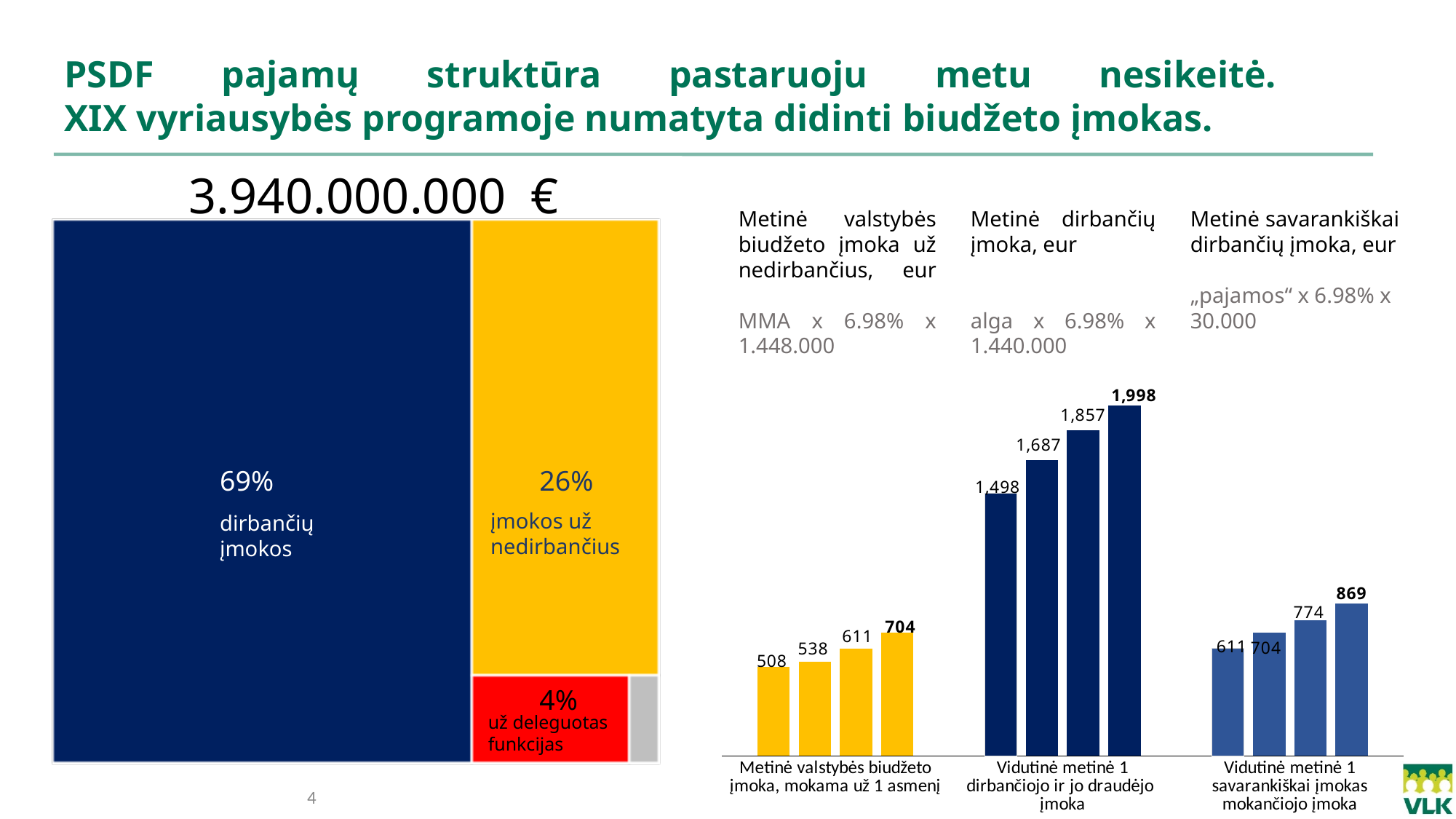
In the right chart, which category group has the tallest bars: 'Metinė valstybės biudžeto įmoka, mokama už 1 asmenį' or 'Vidutinė metinė 1 dirbančiojo ir jo draudėjo įmoka'? Vidutinė metinė 1 dirbančiojo ir jo draudėjo įmoka In the left chart, what share is labelled 'už deleguotas funkcijas'? 4% In the right chart, what is the difference between the highest and lowest values for 'Metinė valstybės biudžeto įmoka, mokama už 1 asmenį'? 196 In the left chart, what share of PSDF income comes from 'dirbančių įmokos'? 69% In the right chart, what is the lowest value shown for 'Metinė valstybės biudžeto įmoka, mokama už 1 asmenį'? 508 In the right chart, how many bars are shown for each category group? 4 What total amount in euros is shown above the left chart? 3.940.000.000 € In the left chart, what share is labelled 'įmokos už nedirbančius'? 26% In the right chart, do the values within each category group rise or fall from left to right? rise In the right chart, what is the last (rightmost) value shown for 'Vidutinė metinė 1 savarankiškai įmokas mokančiojo įmoka'? 869 In the right chart, what is the highest value shown for 'Vidutinė metinė 1 dirbančiojo ir jo draudėjo įmoka'? 1,998 What kind of chart is the chart on the right side of the slide? bar chart